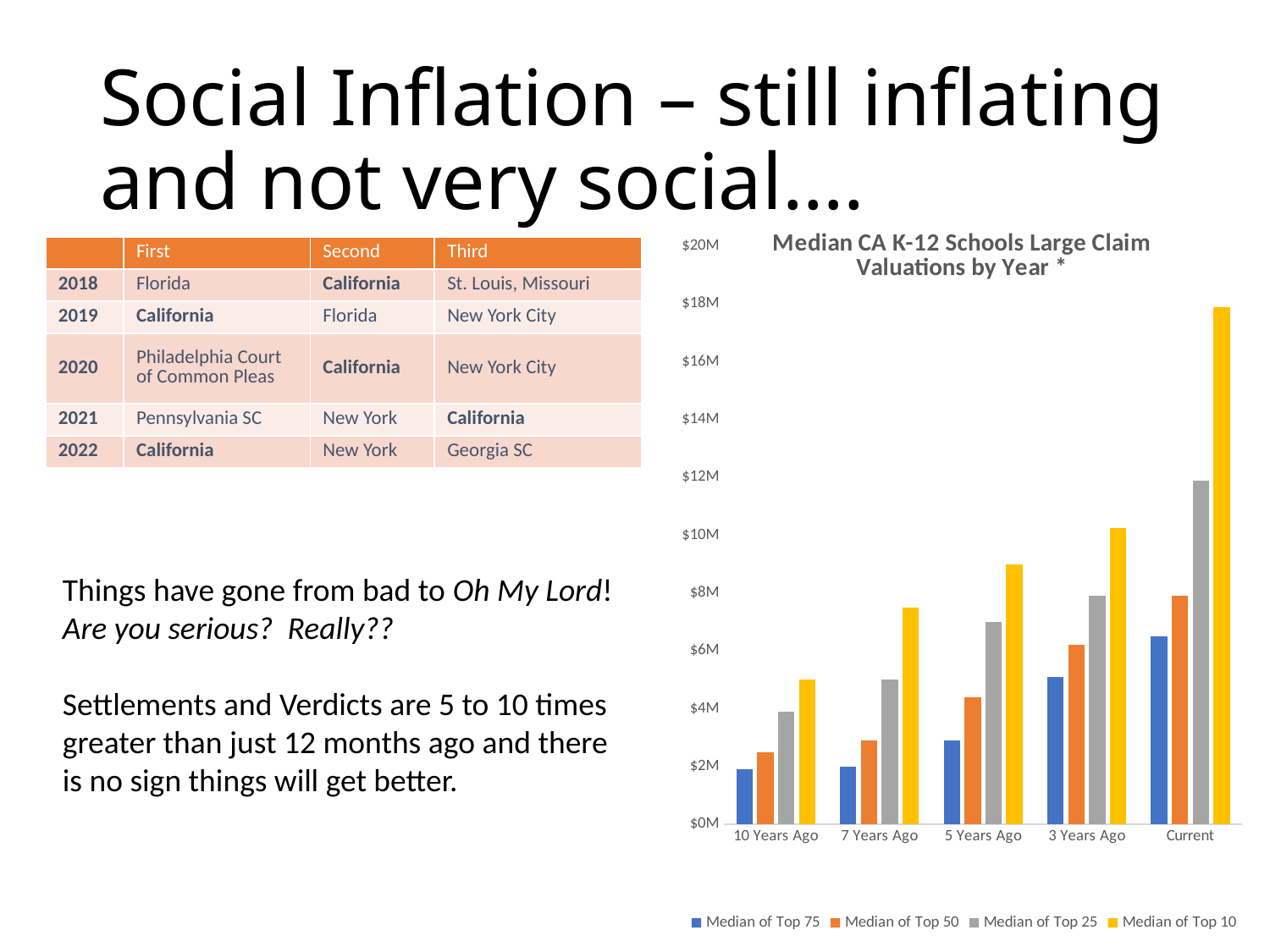
Is the value for Median of Top 10 in the Current category greater or less than $16M? greater Do the Median of Top 10 values rise or fall from 10 Years Ago to Current? Rise How many categories are shown along the x axis of the chart? 5 Which category has the highest value for Median of Top 10? Current How many series does the chart's legend list? 4 Is the value for Median of Top 75 in the Current category greater or less than $8M? less Is the value for Median of Top 75 in the 10 Years Ago category greater or less than $4M? less Which is larger in the Current category: Median of Top 25 or Median of Top 50? Median of Top 25 What kind of chart is shown on the slide? Bar chart Which category has the lowest value for Median of Top 10? 10 Years Ago What is the title of the chart on the slide? Median CA K-12 Schools Large Claim Valuations by Year *